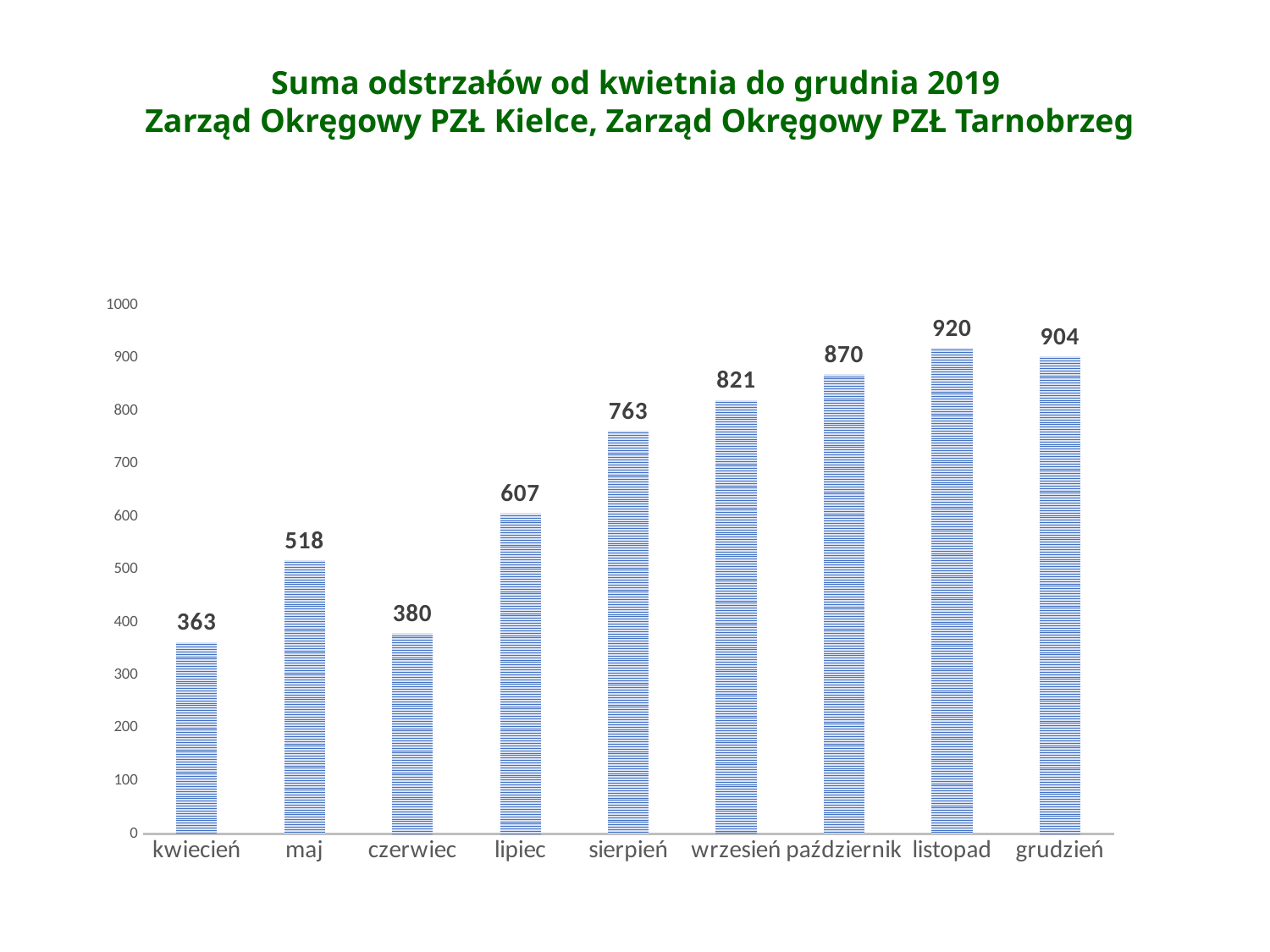
What is the value for wrzesień? 821 What is the value for kwiecień? 363 What is the difference between the values for listopad and grudzień? 16 What is the value for lipiec? 607 Is the value for czerwiec greater or less than 400? less What kind of chart is shown on the slide? bar chart Do the values generally rise or fall from lipiec to listopad? rise Which month has the highest value? listopad What is the difference between the values for maj and czerwiec? 138 Which month has the lowest value? kwiecień Which is larger, the value for sierpień or the value for październik? październik How many months are shown on the x axis? 9